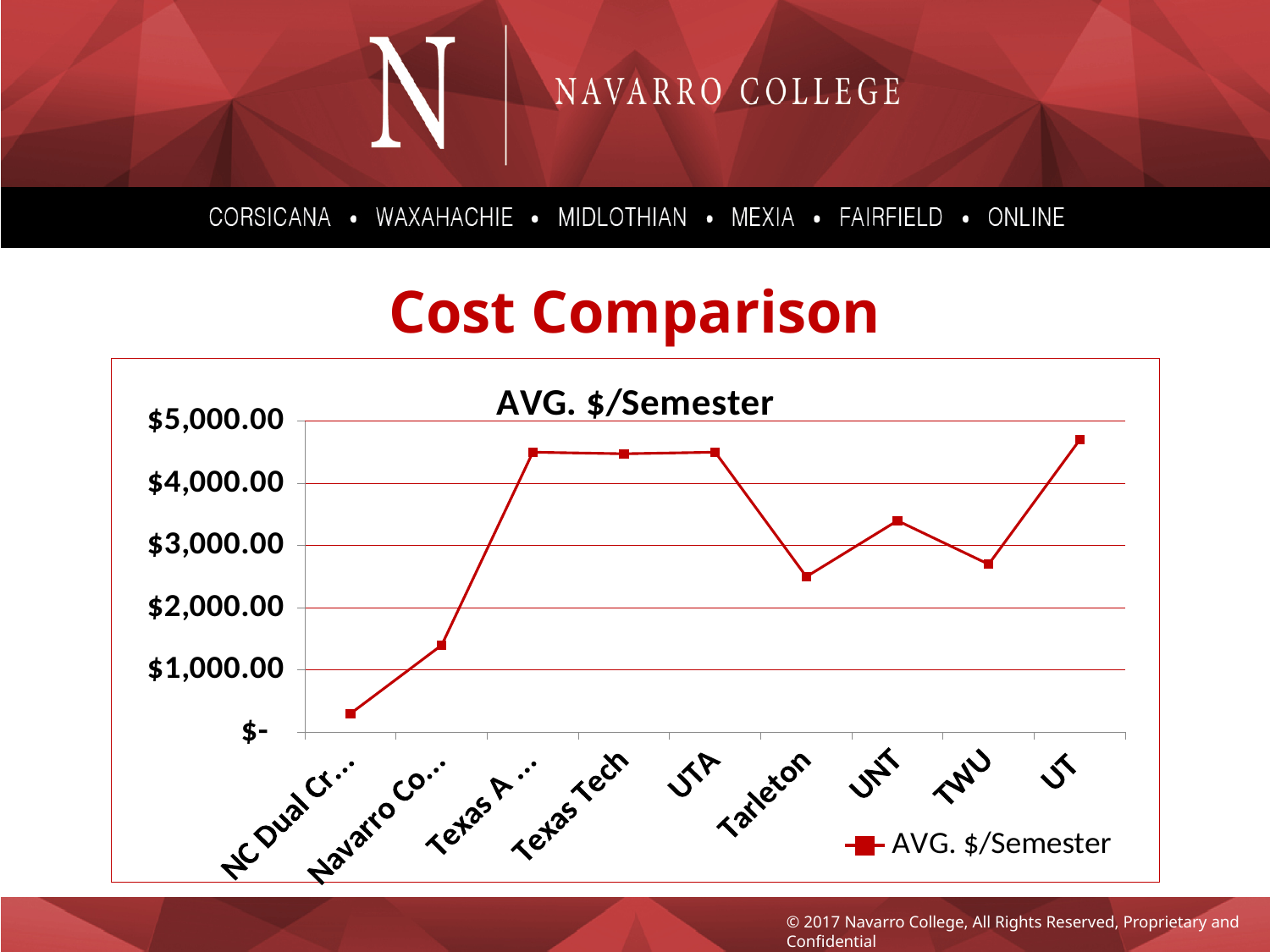
How many series does the legend list? 1 Is the value for TWU greater or less than $3,000.00? less What kind of chart is shown on the slide? line chart Is the value for Tarleton greater or less than $3,000.00? less Is the value for UNT greater or less than $3,000.00? greater Which category has the lowest average cost per semester? NC Dual Cr… How many categories are plotted along the x axis? 9 Which is larger, the value for UNT or the value for Tarleton? UNT What is the title of the chart? AVG. $/Semester Do the values rise or fall from the first category (NC Dual Cr…) to Texas Tech? rise Which category has the highest average cost per semester? UT